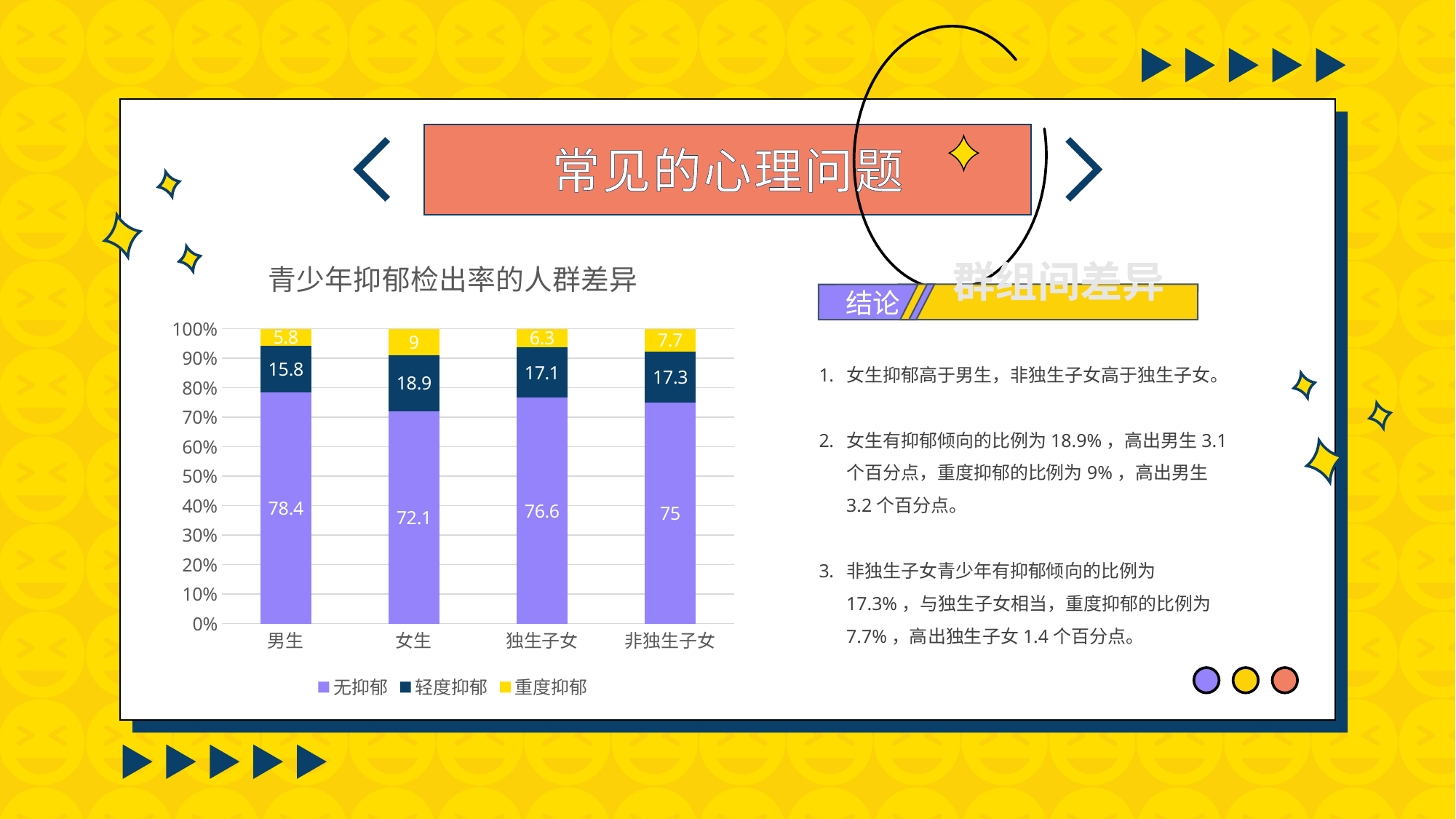
What is the 无抑郁 value for 男生? 78.4 What is the 重度抑郁 value for 女生? 9 Which is larger, the 重度抑郁 value for 非独生子女 or for 独生子女? 非独生子女 What is the total of the stacked bar for 独生子女? 100 Which category has the highest 无抑郁 value? 男生 What is the title of the chart? 青少年抑郁检出率的人群差异 How many series does the legend list? 3 What is the 轻度抑郁 value for 非独生子女? 17.3 What kind of chart is shown? Stacked bar chart What is the difference between the 轻度抑郁 values for 女生 and 男生? 3.1 How many categories are shown on the x axis? 4 Which category has the lowest 重度抑郁 value? 男生